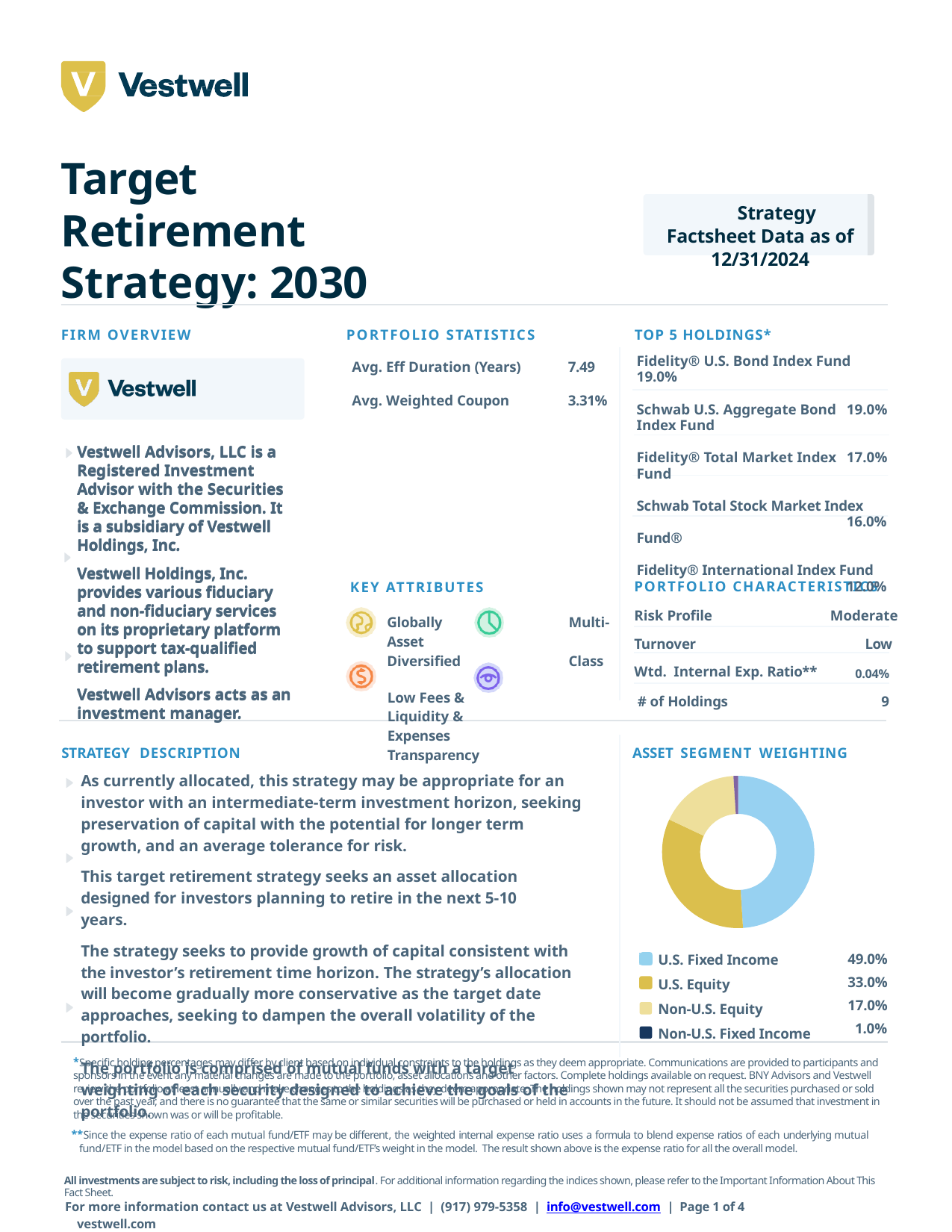
Which asset segment has the largest weighting in the Asset Segment Weighting chart? U.S. Fixed Income In the Asset Segment Weighting chart, what is the weighting for Non-U.S. Fixed Income? 1.0% How many asset segments are shown in the Asset Segment Weighting chart? 4 In the Asset Segment Weighting chart, what is the difference between the U.S. Fixed Income and U.S. Equity weightings? 16.0% What kind of chart is shown under Asset Segment Weighting? Pie chart (donut) In the Asset Segment Weighting chart, which is larger: U.S. Equity or Non-U.S. Equity? U.S. Equity In the Asset Segment Weighting chart, what is the combined weighting of U.S. Equity and Non-U.S. Equity? 50.0% In the Asset Segment Weighting chart, what is the weighting for U.S. Equity? 33.0% What colour represents U.S. Fixed Income in the Asset Segment Weighting chart? Light blue Which asset segment has the smallest weighting in the Asset Segment Weighting chart? Non-U.S. Fixed Income In the Asset Segment Weighting chart, what is the weighting for U.S. Fixed Income? 49.0% In the Asset Segment Weighting chart, what is the weighting for Non-U.S. Equity? 17.0%